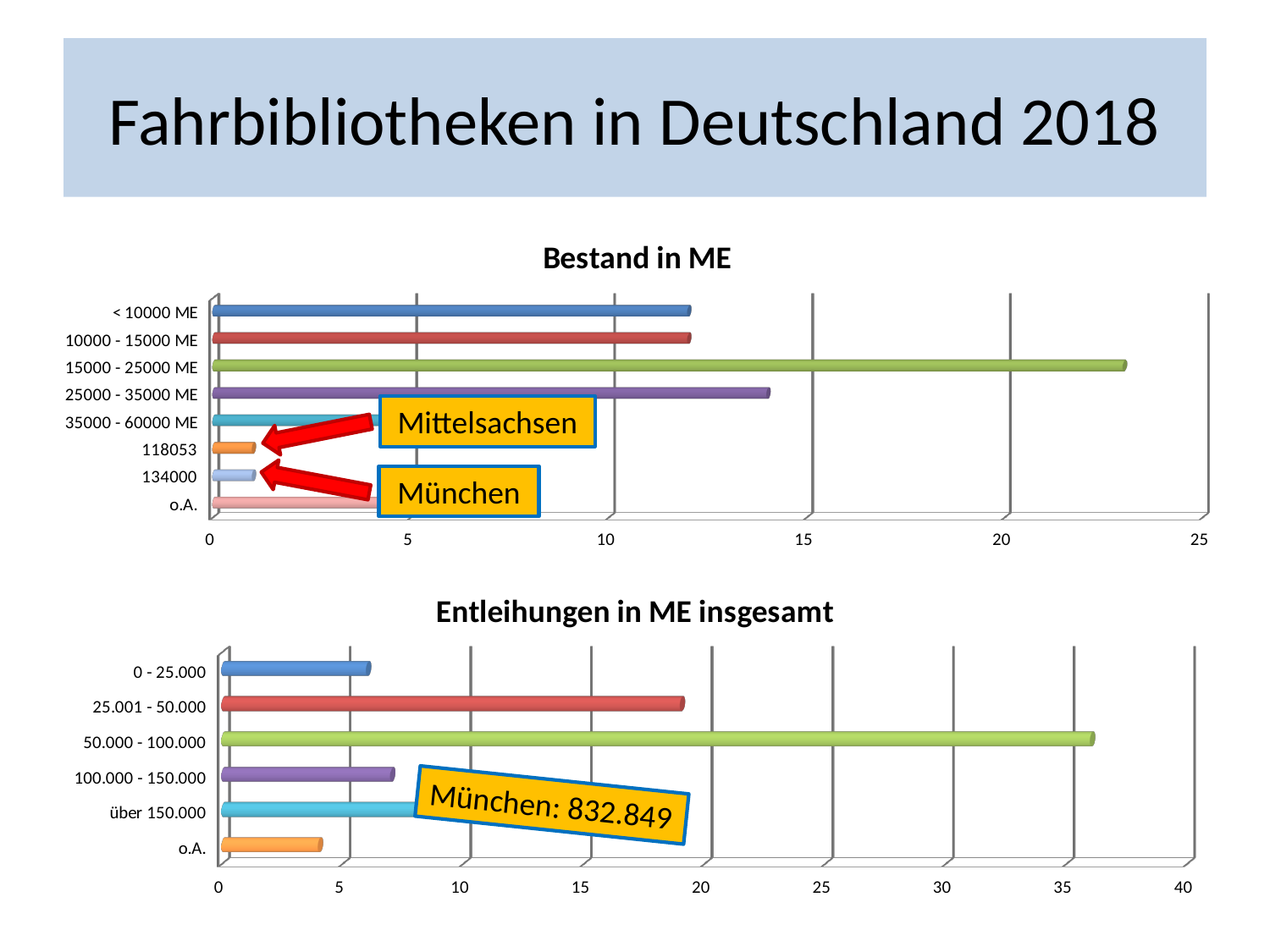
In the "Bestand in ME" chart, which category has the highest value? 15000 - 25000 ME How many categories are shown in the "Bestand in ME" chart? 8 In the "Bestand in ME" chart, which is larger: the value for "25000 - 35000 ME" or the value for "o.A."? 25000 - 35000 ME In the "Bestand in ME" chart, is the value for "15000 - 25000 ME" greater or less than 20? greater How many categories are shown in the "Entleihungen in ME insgesamt" chart? 6 In the "Entleihungen in ME insgesamt" chart, which category has the highest value? 50.000 - 100.000 What kind of chart is the "Bestand in ME" chart? bar chart What is the title of the bottom chart on the slide? Entleihungen in ME insgesamt In the "Entleihungen in ME insgesamt" chart, which is larger: the value for "25.001 - 50.000" or the value for "0 - 25.000"? 25.001 - 50.000 In the "Bestand in ME" chart, is the value for "25000 - 35000 ME" greater or less than 15? less In the "Entleihungen in ME insgesamt" chart, is the value for "50.000 - 100.000" greater or less than 35? greater